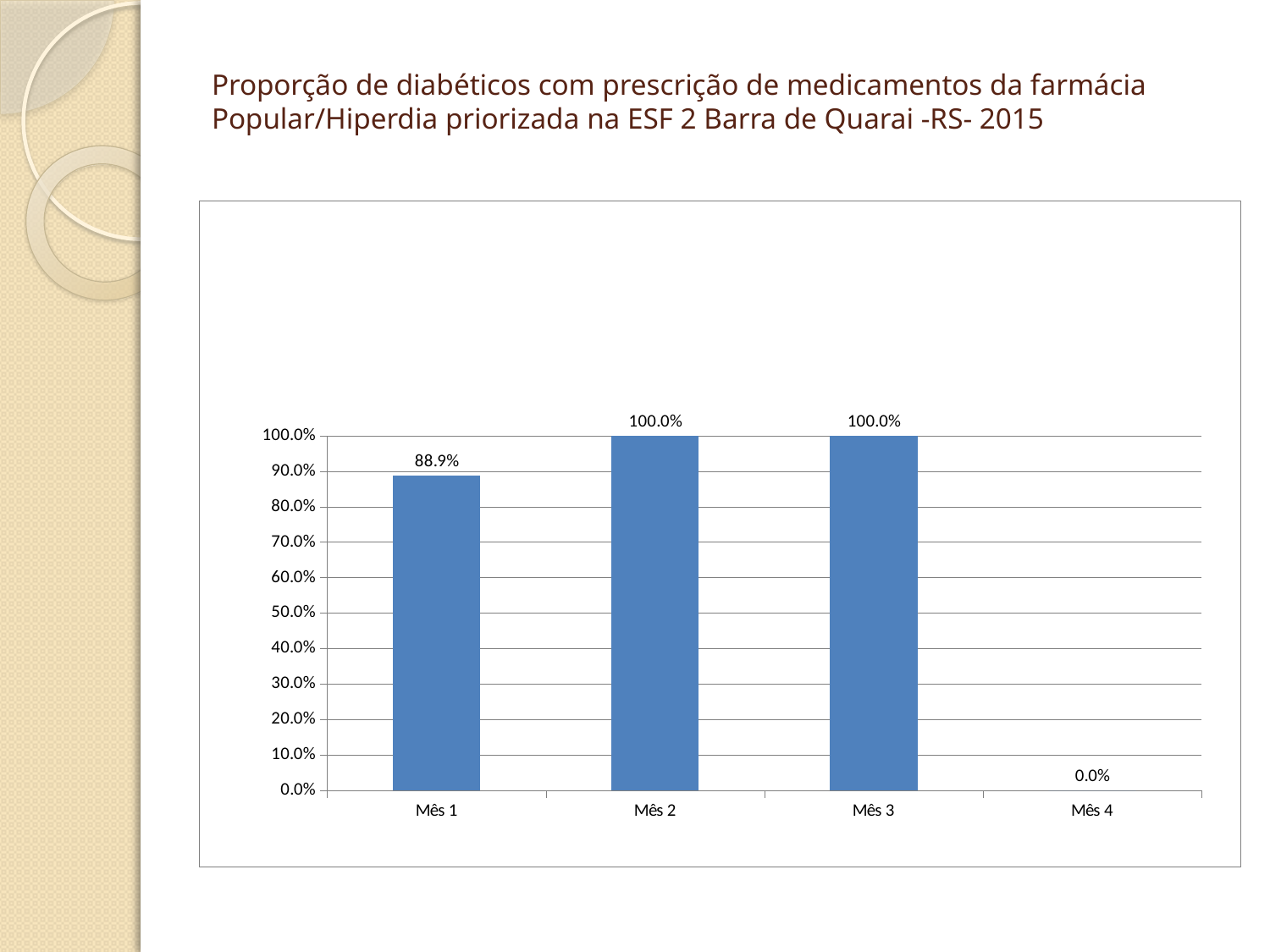
What is the value for Mês 2? 100.0% Which is larger, the value for Mês 1 or the value for Mês 3? Mês 3 What year is mentioned in the slide title? 2015 What is the value for Mês 4? 0.0% How many months are shown on the x axis? 4 What kind of chart is shown on the slide? bar chart Do the values for Mês 2 and Mês 3 differ? No, both are 100.0% What is the difference between the values for Mês 2 and Mês 1? 11.1% What is the value for Mês 1? 88.9% What is the highest value shown on the y axis? 100.0% Which month has the lowest value? Mês 4 Is the value for Mês 1 greater or less than 80.0%? greater